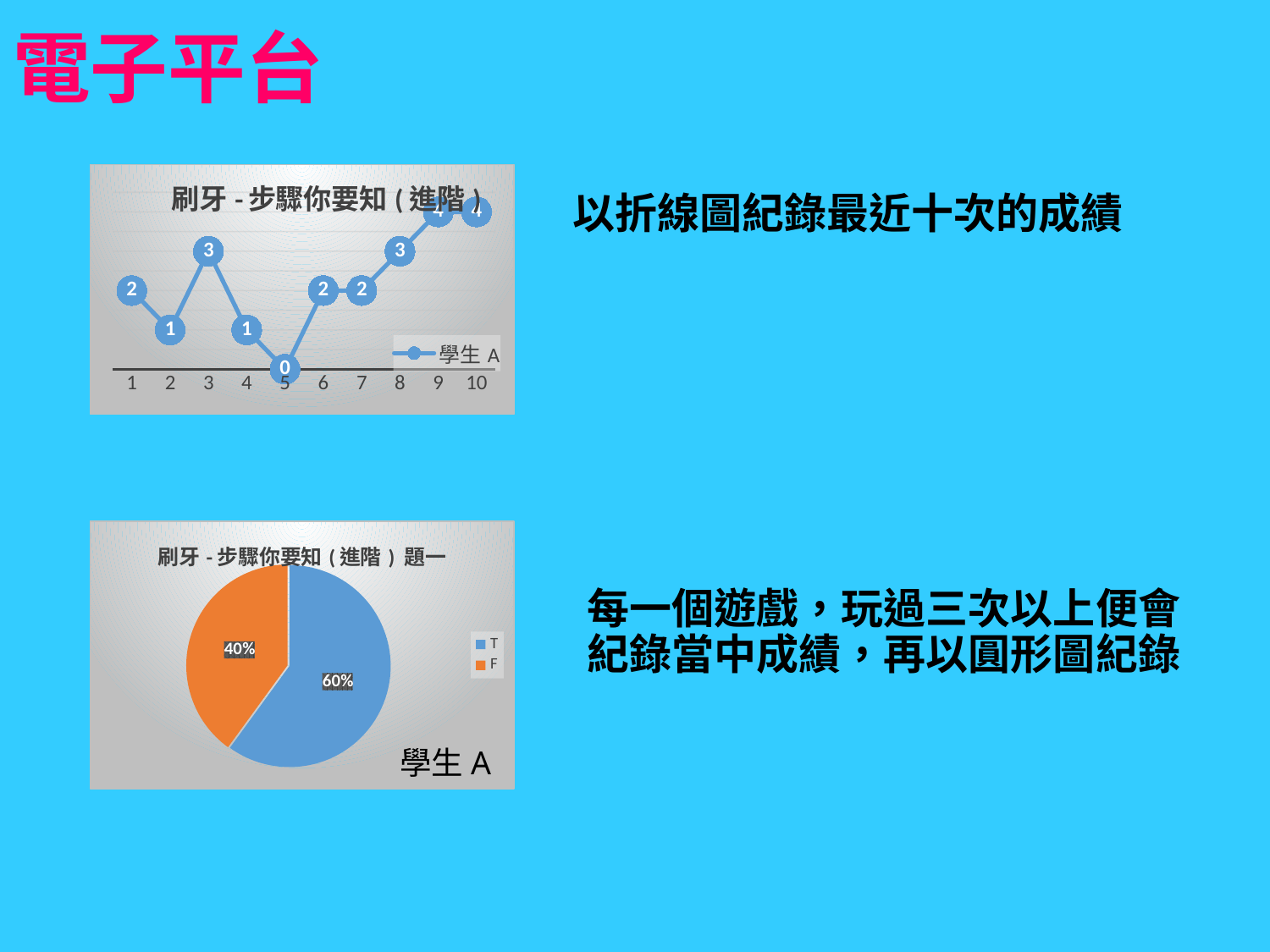
In the line chart at the top left, what is the value at x = 5? 0 What kind of chart is the bottom-left chart? pie chart In the line chart at the top left, which is larger, the value at x = 1 or the value at x = 2? x = 1 In the line chart at the top left, what is the value at x = 10? 4 In the pie chart at the bottom left, what share does T have? 60% In the line chart at the top left, how many data points are plotted? 10 In the line chart at the top left, what series name does the legend show? 學生 A In the line chart at the top left, what is the value at x = 3? 3 In the line chart at the top left, at which x value is the lowest point? 5 In the line chart at the top left, do the values rise or fall from x = 5 to x = 10? rise In the pie chart at the bottom left, what share does F have? 40% In the line chart at the top left, what is the difference between the values at x = 3 and x = 4? 2